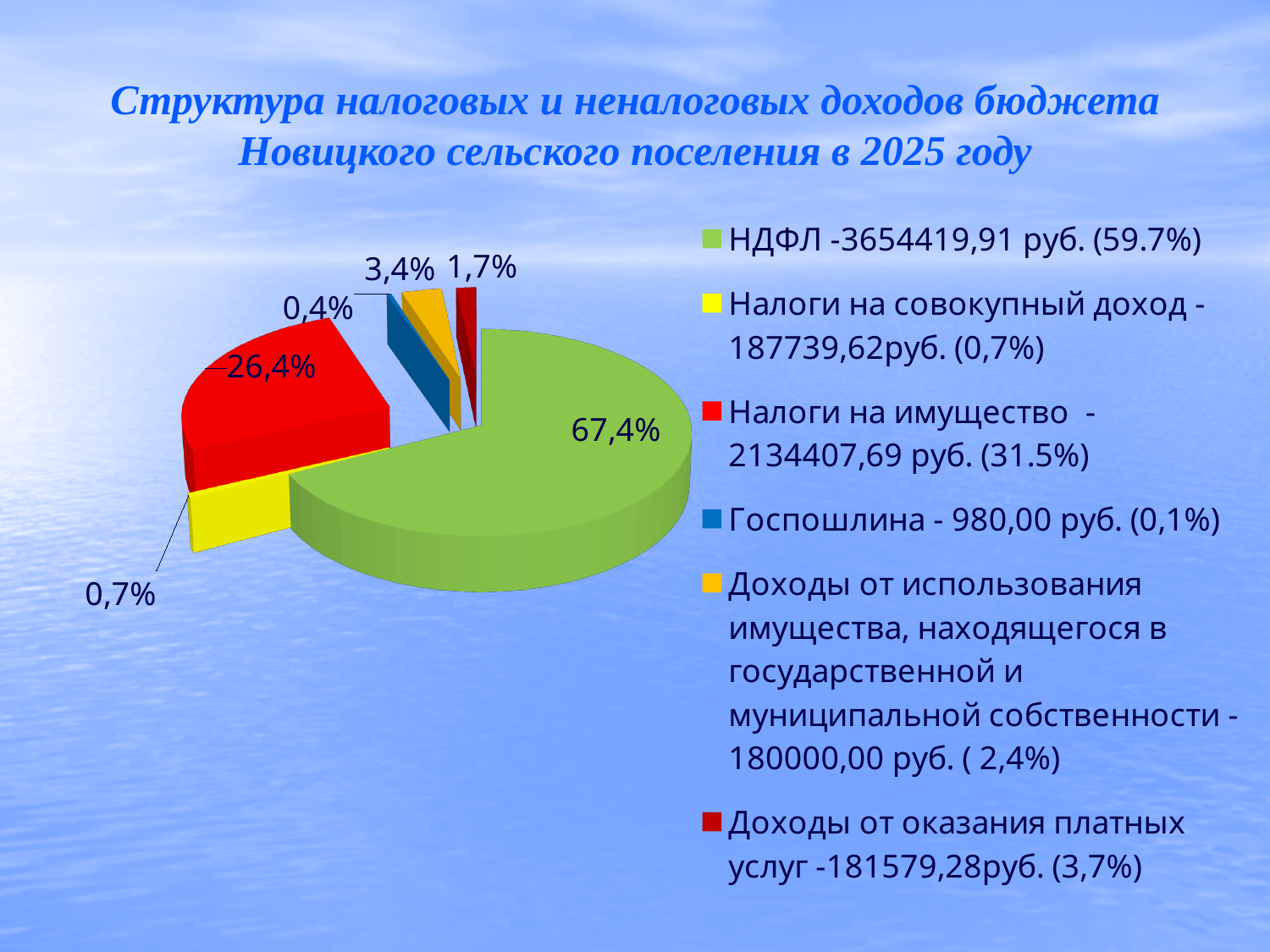
According to the data label on the pie, what share does the red Налоги на имущество slice have? 26,4% What is the difference between the pie data labels for НДФЛ (67,4%) and Налоги на имущество (26,4%)? 41 percentage points Which slice is larger on the pie: Налоги на имущество or Доходы от оказания платных услуг? Налоги на имущество How many slices does the pie chart have? 6 According to the data label on the pie, what share does the blue Госпошлина slice have? 0,4% How many entries does the legend list? 6 According to the data label on the pie, what share does the orange slice (Доходы от использования имущества) have? 3,4% According to the data label on the pie, what share does the green НДФЛ slice have? 67,4% Which slice of the pie chart is the largest? НДФЛ What kind of chart is shown on the slide? pie chart Which slice of the pie chart is the smallest? Госпошлина According to the data label on the pie, what share does the yellow Налоги на совокупный доход slice have? 0,7%